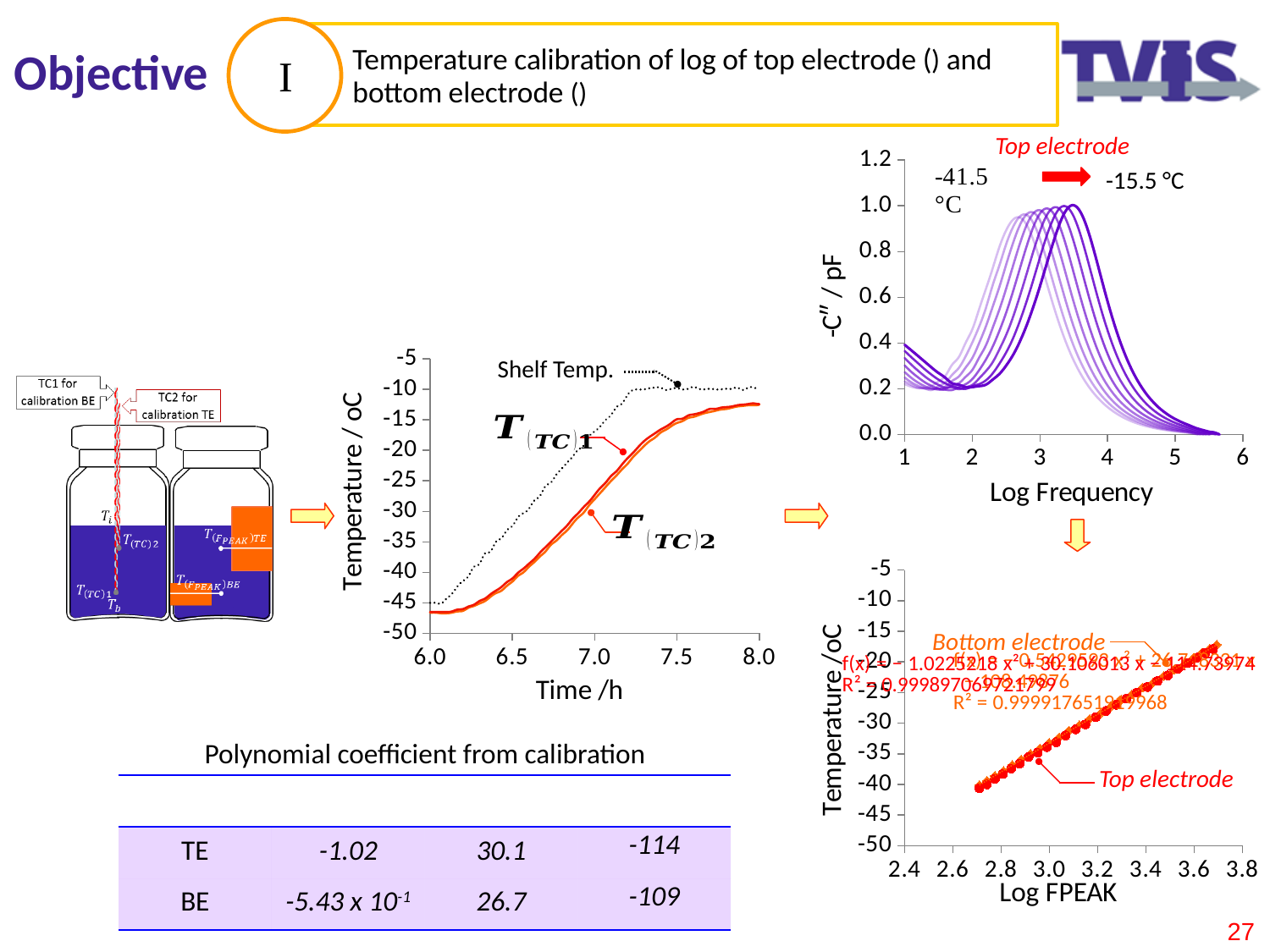
In the Temperature vs Log FPEAK chart, is the temperature at Log FPEAK 2.7 greater or less than -35? less In the -C'' / pF vs Log Frequency chart, what is the maximum value shown on the y axis? 1.2 In the Temperature vs Time chart, what is the label of the x axis? Time /h In the Temperature vs Time chart, what kind of chart is it? line chart In the -C'' / pF vs Log Frequency chart, what is the label of the x axis? Log Frequency In the Temperature vs Time chart, which series is drawn as a dotted line? Shelf Temp. In the Temperature vs Time chart, is the Shelf Temp. value at 7.5 h greater or less than -15? greater In the Temperature vs Time chart, is the T(TC)2 value at 7.0 h greater or less than -25? less In the Temperature vs Log FPEAK chart, how many series are plotted? 2 In the Temperature vs Log FPEAK chart, does temperature rise or fall as Log FPEAK increases? rise In the Temperature vs Time chart, do the temperature curves rise or fall as time increases from 6.0 h to 8.0 h? rise